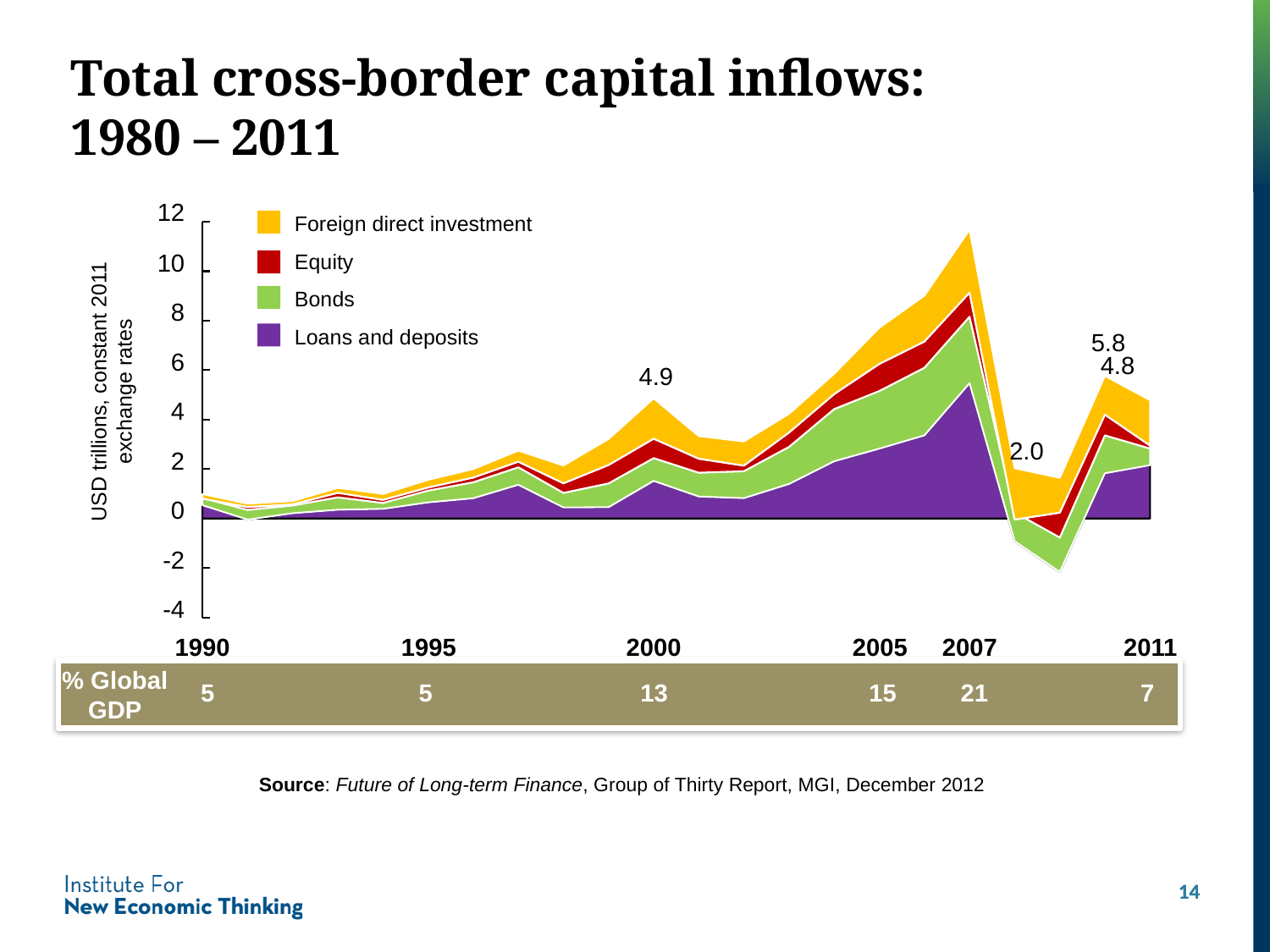
What is the y-axis label of the chart? USD trillions, constant 2011 exchange rates What is the difference between the % Global GDP figures for 2007 and 2011? 14 Is the total value for 2007 greater or less than 10? greater What is the % Global GDP figure shown for 2007? 21 Which year has the larger % Global GDP figure, 2007 or 2011? 2007 In which labeled year do total cross-border capital inflows reach their highest point? 2007 What total value is labeled at the 2000 peak of the chart? 4.9 What kind of chart is shown on the slide? Stacked area chart What is the % Global GDP figure shown for 2000? 13 How many series does the legend list? 4 Is the total value for 1990 greater or less than 2? less Which series is shown in purple in the legend? Loans and deposits